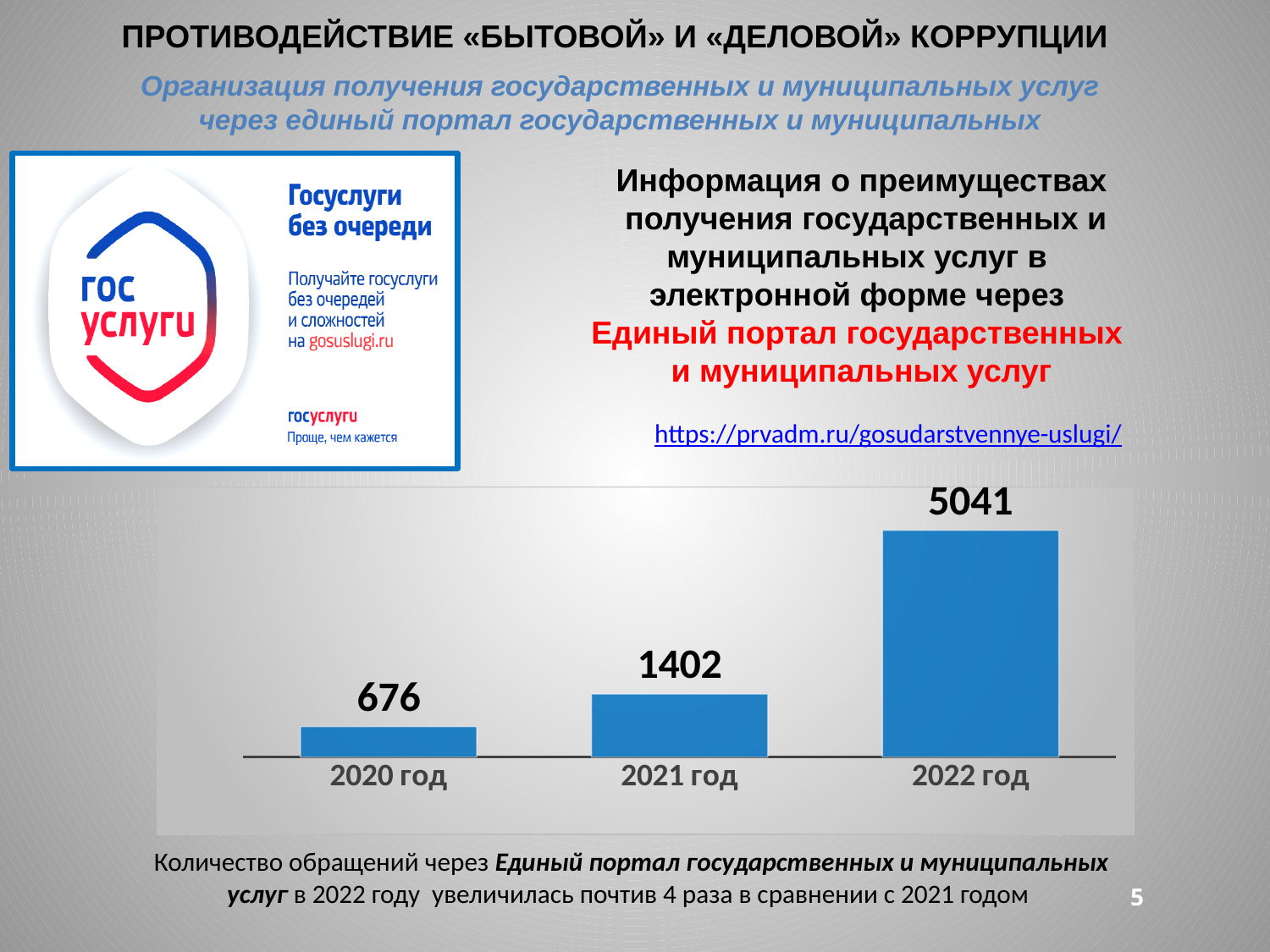
What kind of chart is shown on the slide? bar chart Do the values rise or fall from 2020 год to 2022 год? rise What colour are the bars in the chart? blue Which year has the highest value? 2022 год Which year has the lowest value? 2020 год What is the value for 2020 год? 676 What is the difference between the values for 2022 год and 2021 год? 3639 What is the difference between the values for 2021 год and 2020 год? 726 What is the value for 2022 год? 5041 How many categories are shown on the x axis? 3 Which is larger, the value for 2021 год or the value for 2020 год? 2021 год What is the value for 2021 год? 1402